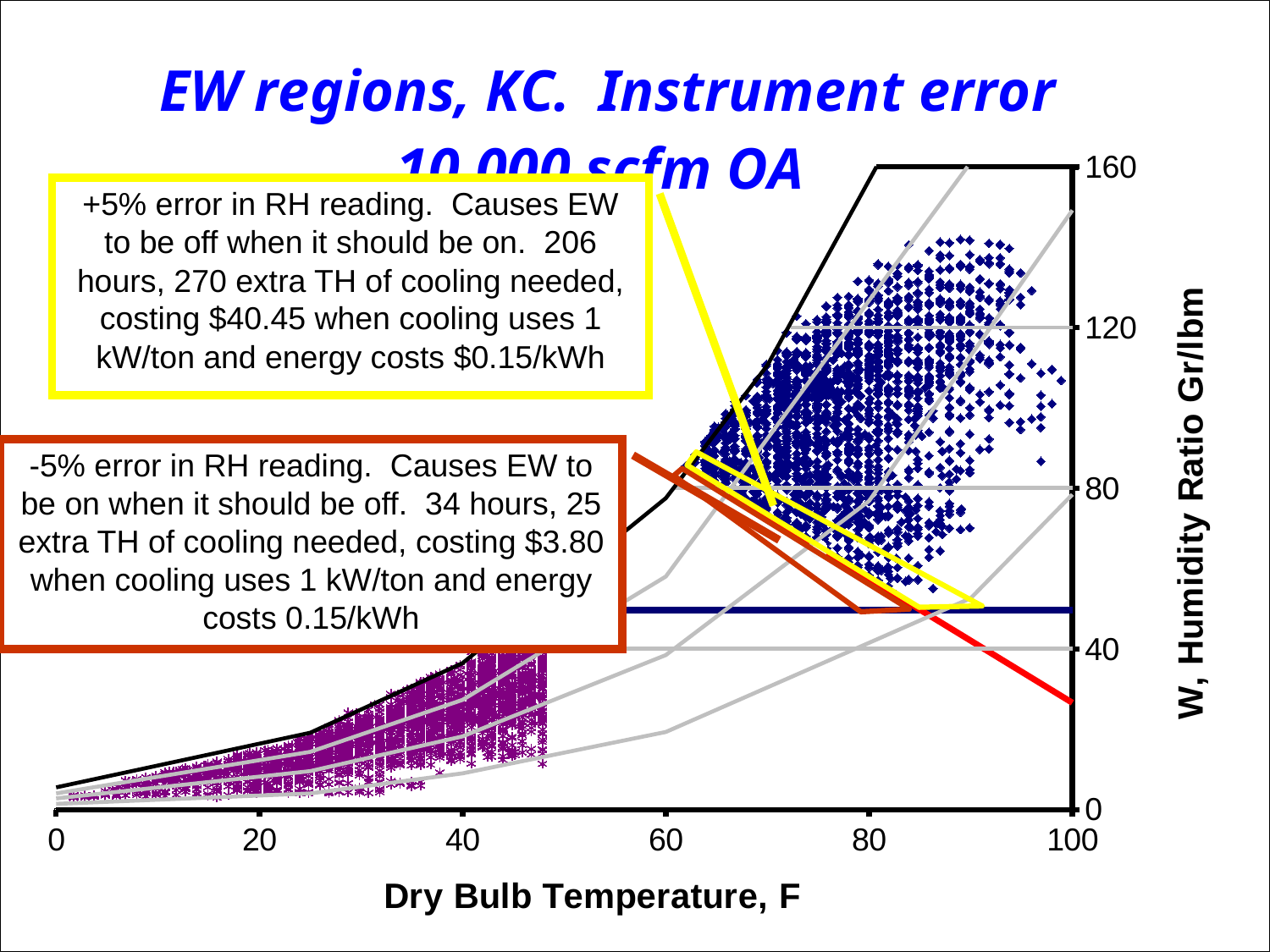
What is the title of the chart's horizontal axis? Dry Bulb Temperature, F Is the humidity ratio of the red line at 100 F greater or less than 40? less Does the red line rise or fall as dry bulb temperature increases from 85 to 100 F? fall Are the purple points at a dry bulb temperature of 20 F greater or less than 40 on the humidity ratio axis? less Which group of points reaches higher humidity ratios, the blue diamonds or the purple asterisks? blue diamonds How many tick labels are shown on the vertical axis? 5 Is the humidity ratio of the horizontal dark blue line greater or less than 40? greater Does the black boundary curve rise or fall as dry bulb temperature increases from 0 to 100 F? rise What is the title of the chart's vertical axis? W, Humidity Ratio Gr/lbm What kind of chart is shown on the slide? scatter chart How many tick labels are shown on the horizontal axis? 6